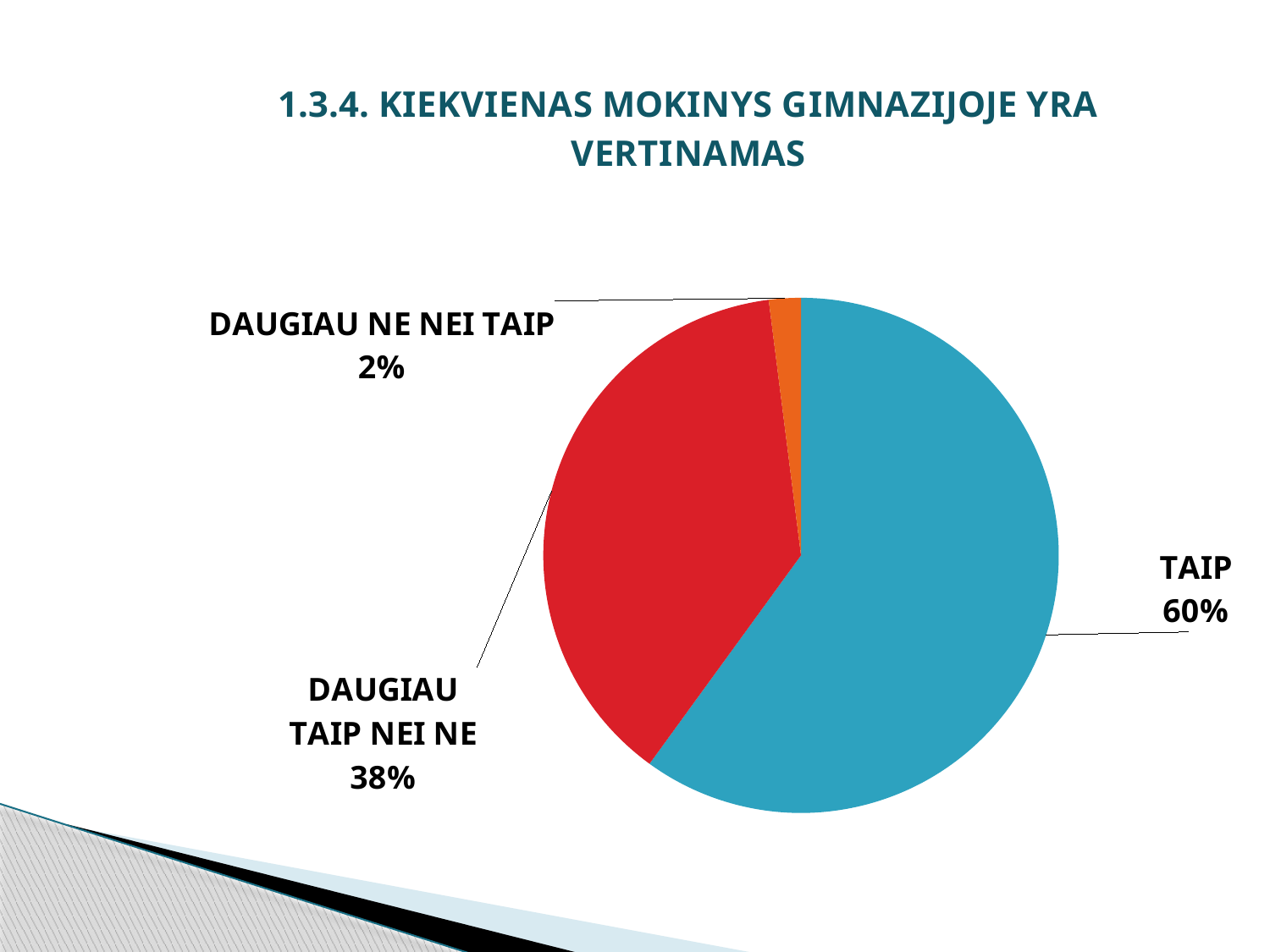
What is the difference in percentage points between DAUGIAU TAIP NEI NE and DAUGIAU NE NEI TAIP? 36 What colour is the slice for DAUGIAU TAIP NEI NE? red What share of the pie does TAIP have? 60% What share of the pie does DAUGIAU NE NEI TAIP have? 2% What is the difference in percentage points between TAIP and DAUGIAU TAIP NEI NE? 22 Which category has the largest slice of the pie? TAIP What is the title of the chart? 1.3.4. KIEKVIENAS MOKINYS GIMNAZIJOJE YRA VERTINAMAS What share of the pie does DAUGIAU TAIP NEI NE have? 38% Which category has the smallest slice of the pie? DAUGIAU NE NEI TAIP What kind of chart is shown on the slide? pie chart How many slices does the pie chart have? 3 Which is larger, the slice for TAIP or the slice for DAUGIAU TAIP NEI NE? TAIP